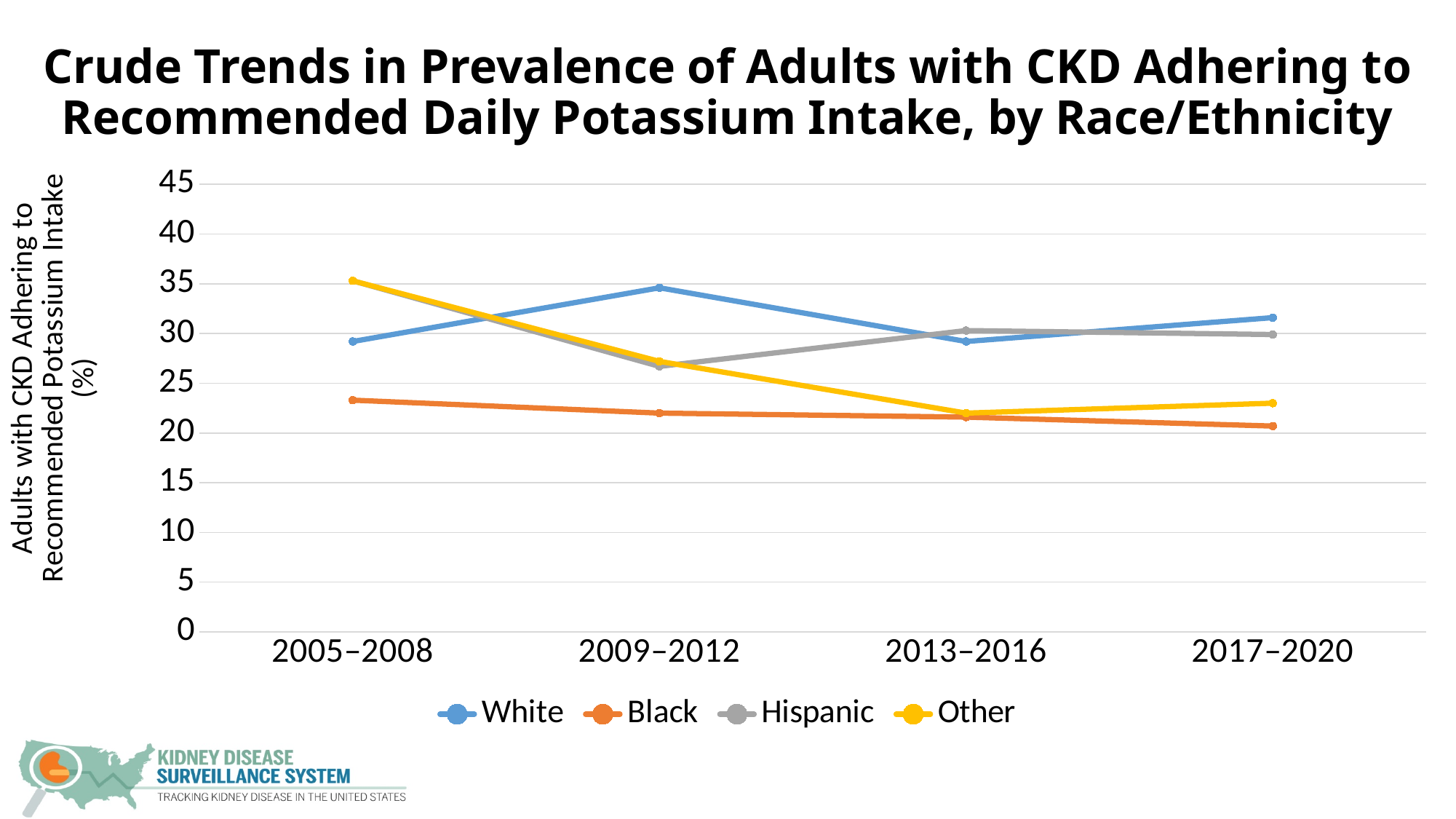
Is the value for Other in 2013–2016 greater or less than 25? less Is the value for Black in 2017–2020 greater or less than 25? less Do the values for the Black series rise or fall from 2005–2008 to 2017–2020? fall How many series does the legend list? 4 What is the label on the y axis? Adults with CKD Adhering to Recommended Potassium Intake (%) How many time periods are shown on the x axis? 4 In 2005–2008, which is larger: the value for Other or the value for Black? Other What kind of chart is shown on the slide? line chart Which race/ethnicity group has the lowest value in 2017–2020? Black In 2009–2012, which is larger: the value for White or the value for Hispanic? White Is the value for White in 2009–2012 greater or less than 30? greater Which race/ethnicity group has the highest value in 2009–2012? White